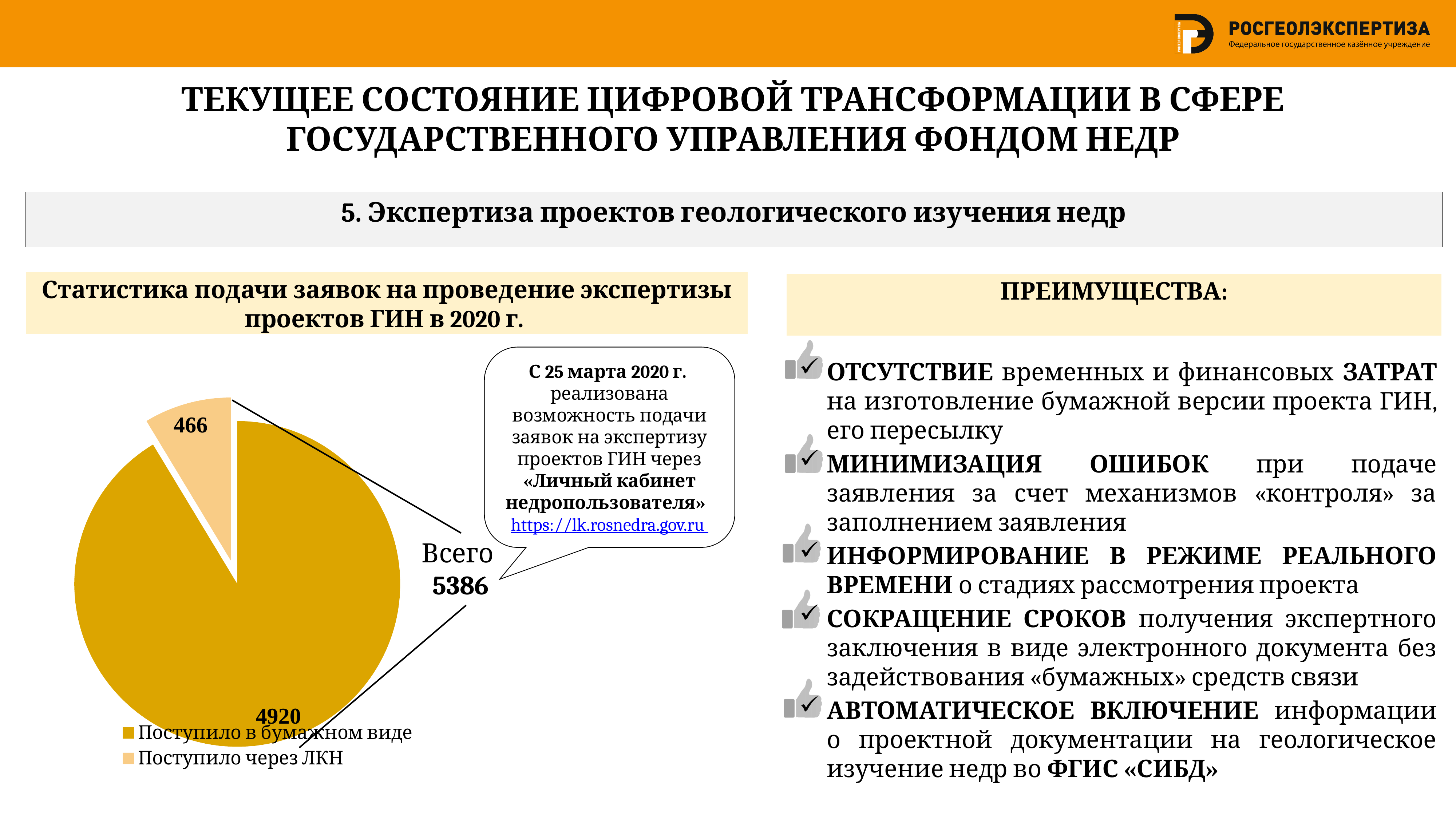
How many slices does the pie chart have? 2 What is the total number of applications shown next to the pie chart ("Всего")? 5386 Which category has the smallest slice of the pie? Поступило через ЛКН Which legend entry is shown in the lighter (pale orange) colour? Поступило через ЛКН Which category has the largest slice of the pie? Поступило в бумажном виде What is the value for "Поступило в бумажном виде"? 4920 What is the title of the chart section on the left of the slide? Статистика подачи заявок на проведение экспертизы проектов ГИН в 2020 г. What type of chart is shown on the slide? pie chart What is the value for "Поступило через ЛКН"? 466 What is the difference between the values for "Поступило в бумажном виде" and "Поступило через ЛКН"? 4454 Which is larger: "Поступило в бумажном виде" or "Поступило через ЛКН"? Поступило в бумажном виде How many entries does the legend list? 2